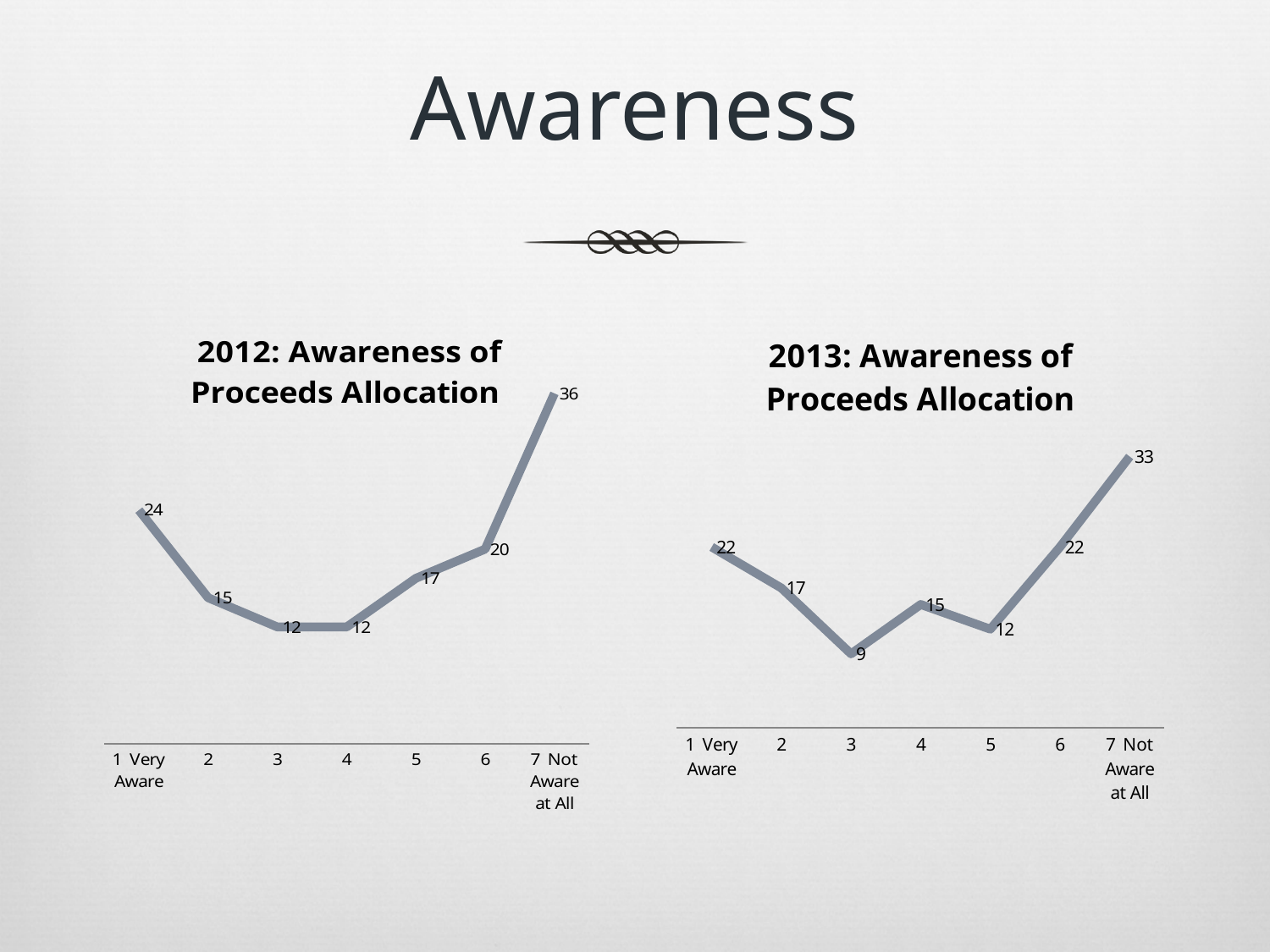
In the 2012: Awareness of Proceeds Allocation chart, what is the value for category 7 Not Aware at All? 36 In the 2013: Awareness of Proceeds Allocation chart, what is the difference between the values for 7 Not Aware at All and 6? 11 In the 2013: Awareness of Proceeds Allocation chart, which category has the lowest value? 3 In the 2013: Awareness of Proceeds Allocation chart, which is larger, the value for 4 or the value for 5? 4 In the 2012: Awareness of Proceeds Allocation chart, which category has the highest value? 7 Not Aware at All How many categories are plotted in the 2012: Awareness of Proceeds Allocation chart? 7 In the 2012: Awareness of Proceeds Allocation chart, do the values rise or fall from category 4 to category 7 Not Aware at All? rise Which is larger, the value for 1 Very Aware in the 2012 chart or the value for 1 Very Aware in the 2013 chart? 2012 What is the title of the chart on the right side of the slide? 2013: Awareness of Proceeds Allocation In the 2012: Awareness of Proceeds Allocation chart, what is the difference between the values for 1 Very Aware and 2? 9 In the 2013: Awareness of Proceeds Allocation chart, what is the value for category 3? 9 What kind of chart is the 2013: Awareness of Proceeds Allocation chart? line chart